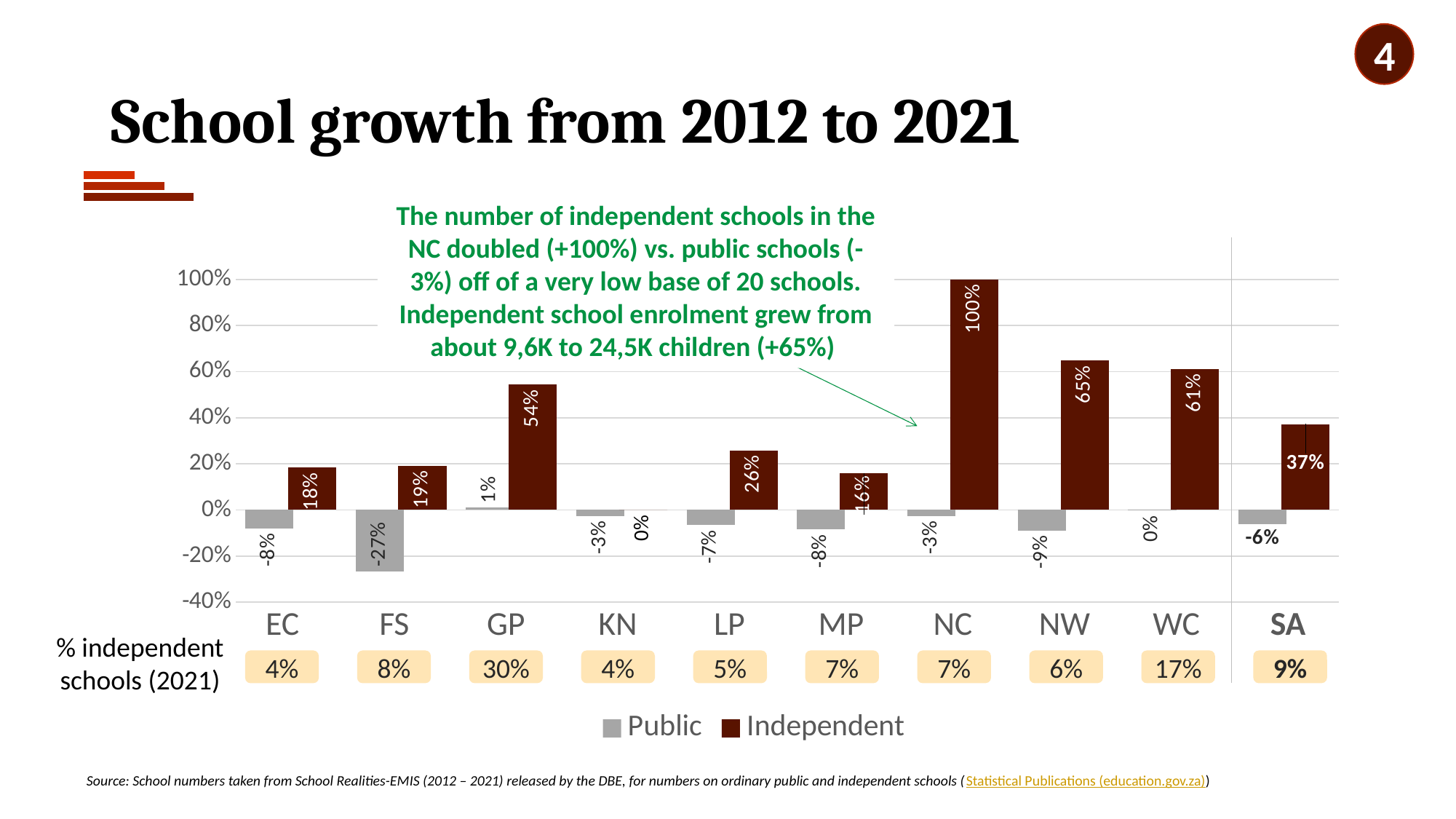
What is the Independent school growth value for NC? 100% What is the Independent school growth value for WC? 61% How many series does the legend list? 2 Which is larger, the Independent growth for GP or the Independent growth for LP? GP What is the % independent schools (2021) figure shown for GP? 30% Which province has the lowest Public school growth? FS How many provinces/categories are shown on the x axis of the chart? 10 Which province has the highest Independent school growth? NC What is the difference between the Independent and Public growth values for NW? 74 percentage points What is the Public school growth value for SA? -6% What is the Public school growth value for FS? -27% What kind of chart is shown on the slide? Bar chart